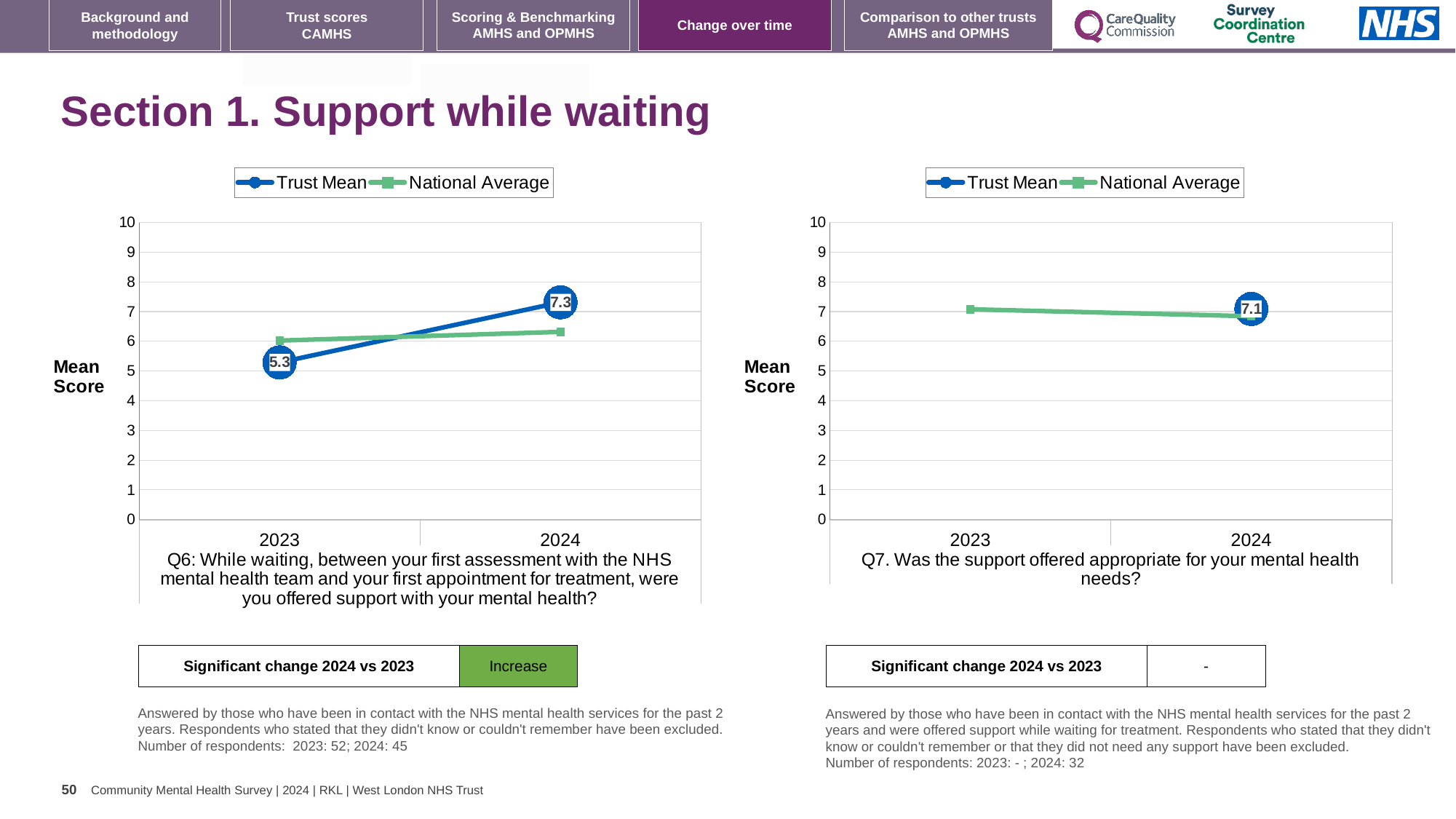
How many series does the legend of the Q7 chart on the right list? 2 In the Q6 chart on the left, what is the Trust Mean score for 2024? 7.3 In the Q6 chart on the left, what is the Trust Mean score for 2023? 5.3 What are the two series named in the legend of the Q6 chart on the left? Trust Mean and National Average In the Q7 chart on the right, what is the Trust Mean score for 2024? 7.1 In the Q6 chart on the left, is the National Average value for 2023 greater or less than 5? greater What kind of chart is the Q6 chart on the left? line chart In the Q6 chart on the left, by how much did the Trust Mean score change from 2023 to 2024? 2.0 In the Q6 chart on the left, which is larger in 2024, the Trust Mean or the National Average? Trust Mean How many years are shown on the x axis of the Q6 chart on the left? 2 In the Q6 chart on the left, does the Trust Mean rise or fall from 2023 to 2024? rise In the Q6 chart on the left, which is larger in 2023, the Trust Mean or the National Average? National Average